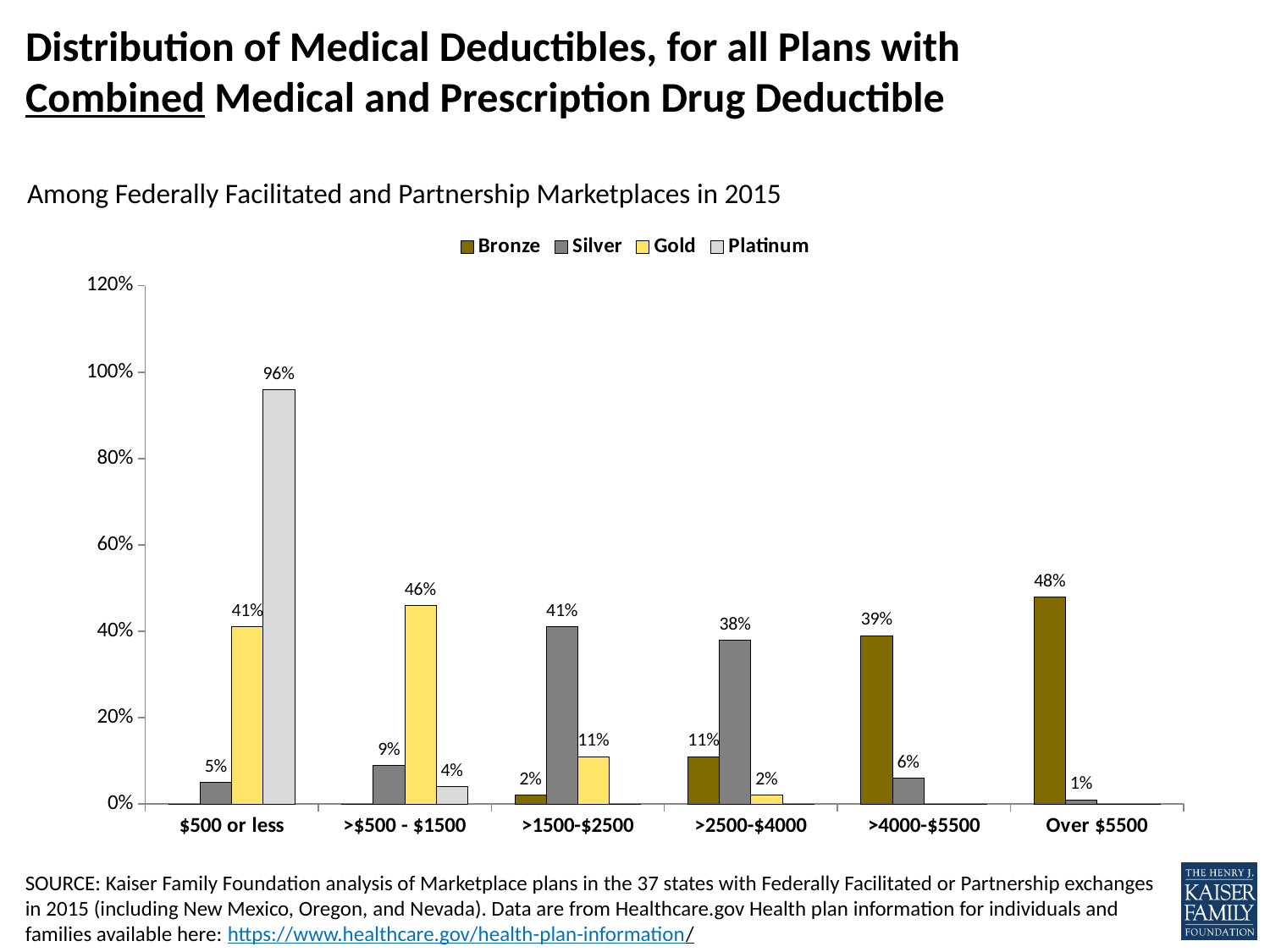
How many series does the legend list? 4 How many deductible categories are shown on the x axis? 6 What is the value for Gold in the ">$500 - $1500" category? 46% In which category does Silver have its lowest labeled value? Over $5500 What is the difference between the Gold value and the Silver value in the "$500 or less" category? 36% Is the value for Platinum in the "$500 or less" category greater or less than 80%? greater Which is larger in the ">4000-$5500" category, Bronze or Silver? Bronze What is the value for Bronze in the "Over $5500" category? 48% What kind of chart is shown on the slide? Bar chart In which category does Bronze have its highest value? Over $5500 What is the value for Platinum in the "$500 or less" category? 96% What is the value for Silver in the ">2500-$4000" category? 38%